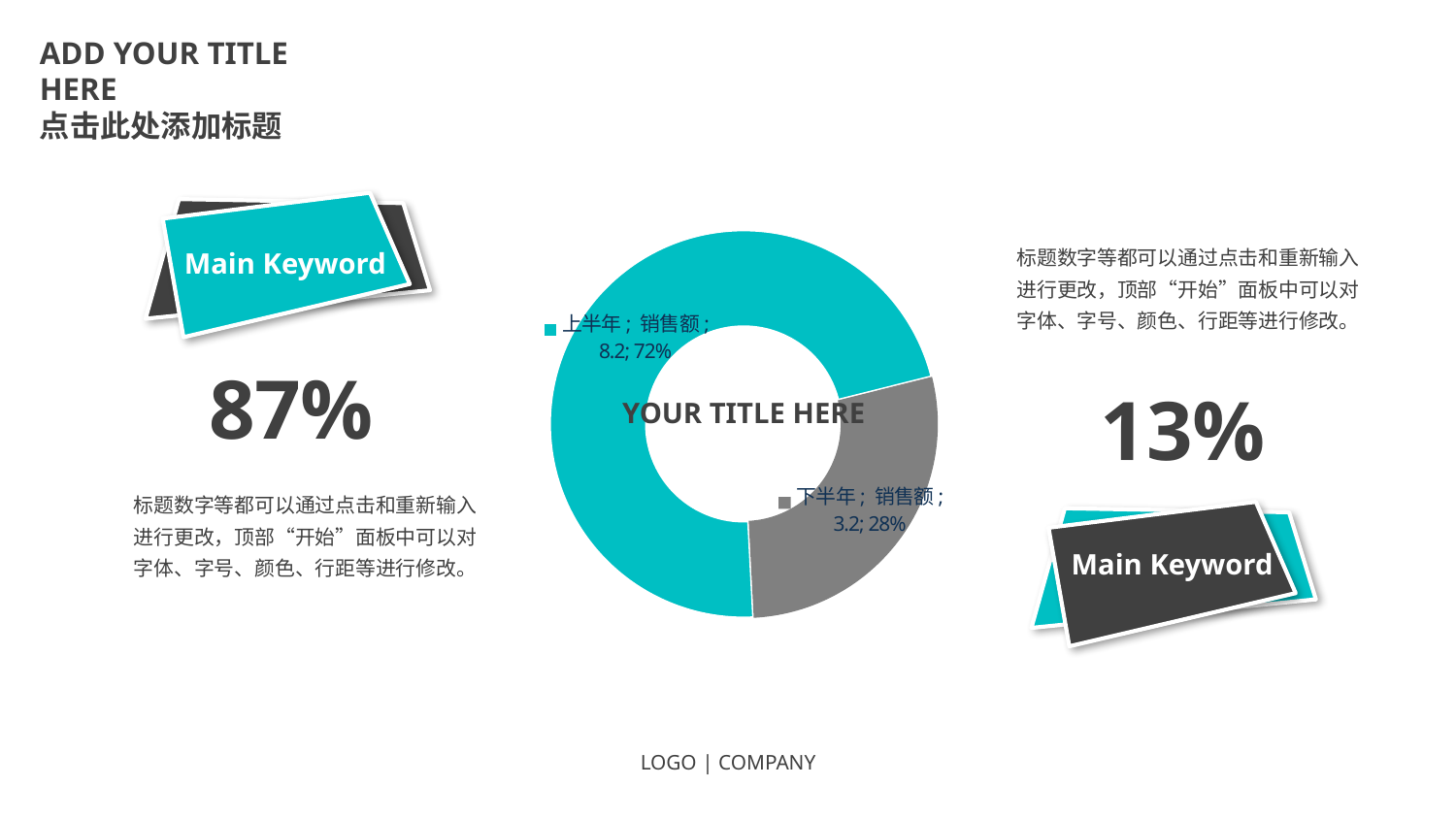
What is the sales value (销售额) for 下半年 in the doughnut chart? 3.2 Which has a larger sales value in the doughnut chart, 上半年 or 下半年? 上半年 Which slice of the doughnut chart is the smallest? 下半年 What is the difference between the sales values for 上半年 and 下半年 in the doughnut chart? 5.0 What title is displayed in the center of the doughnut chart? YOUR TITLE HERE What type of chart is shown on the slide? Doughnut chart How many slices does the doughnut chart have? 2 What colour is the 下半年 slice in the doughnut chart? Gray Which slice of the doughnut chart is the largest? 上半年 What percentage share of the doughnut chart does 下半年 represent? 28% What percentage share of the doughnut chart does 上半年 represent? 72% What is the sales value (销售额) for 上半年 in the doughnut chart? 8.2